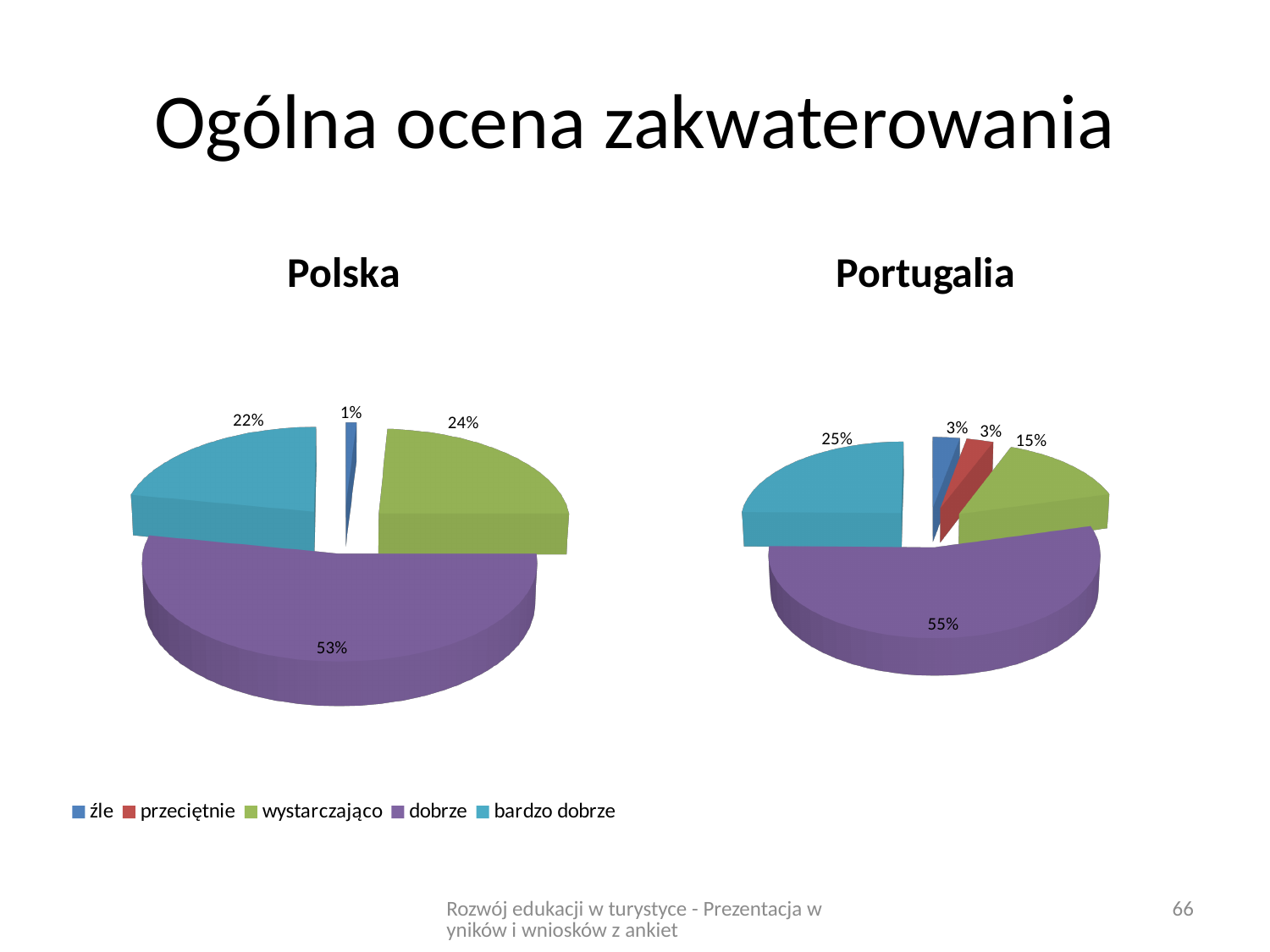
How many categories does the legend list? 5 In the Polska chart, what share is labelled for dobrze? 53% In the Portugalia chart, what share is labelled for wystarczająco? 15% How many slices does the Portugalia pie chart have? 5 In the Portugalia chart, which category has the largest share? dobrze In the Polska chart, what is the difference between the shares for dobrze and bardzo dobrze? 31% In the Portugalia chart, what is the difference between the shares for dobrze and wystarczająco? 40% In the Portugalia chart, what share is labelled for bardzo dobrze? 25% What type of chart is used for Polska? pie chart Which chart shows a larger share for bardzo dobrze, Polska or Portugalia? Portugalia In the Polska chart, what share is labelled for wystarczająco? 24%